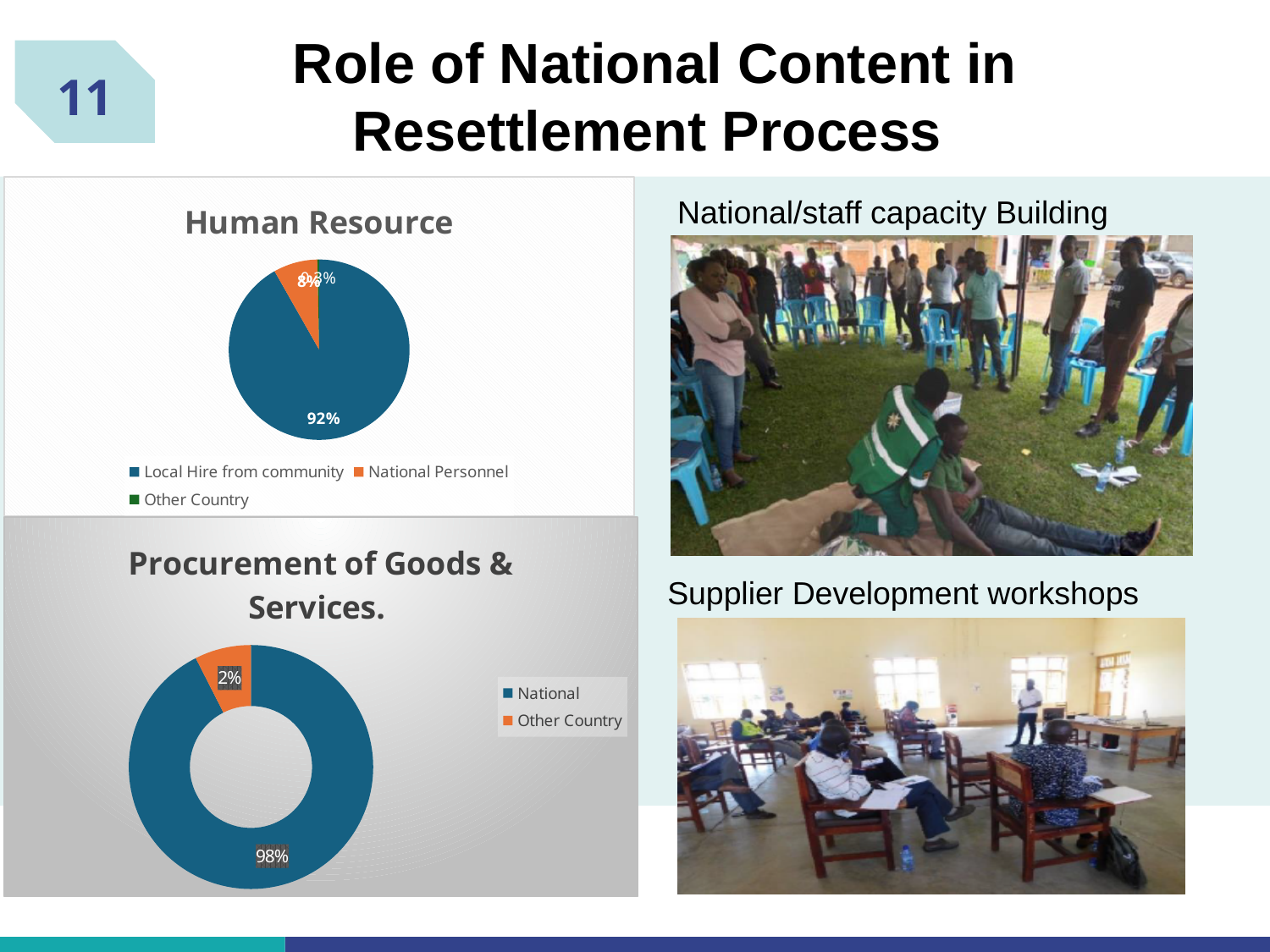
How many categories does the legend of the Human Resource chart list? 3 In the Procurement of Goods & Services chart, what percentage is shown for National? 98% How many categories does the legend of the Procurement of Goods & Services chart list? 2 What kind of chart is the Human Resource chart? Pie chart In the Human Resource chart, is the share for Local Hire from community greater or less than 50%? greater In the Human Resource chart, which category has the largest slice? Local Hire from community In the Procurement of Goods & Services chart, what is the difference in percentage points between National and Other Country? 96 percentage points In the Human Resource chart, what percentage is shown for Local Hire from community? 92% In the Procurement of Goods & Services chart, which category has the largest share? National In the Procurement of Goods & Services chart, what percentage is shown for Other Country? 2% What kind of chart is the Procurement of Goods & Services chart? Doughnut chart In the Procurement of Goods & Services chart, which is larger, National or Other Country? National